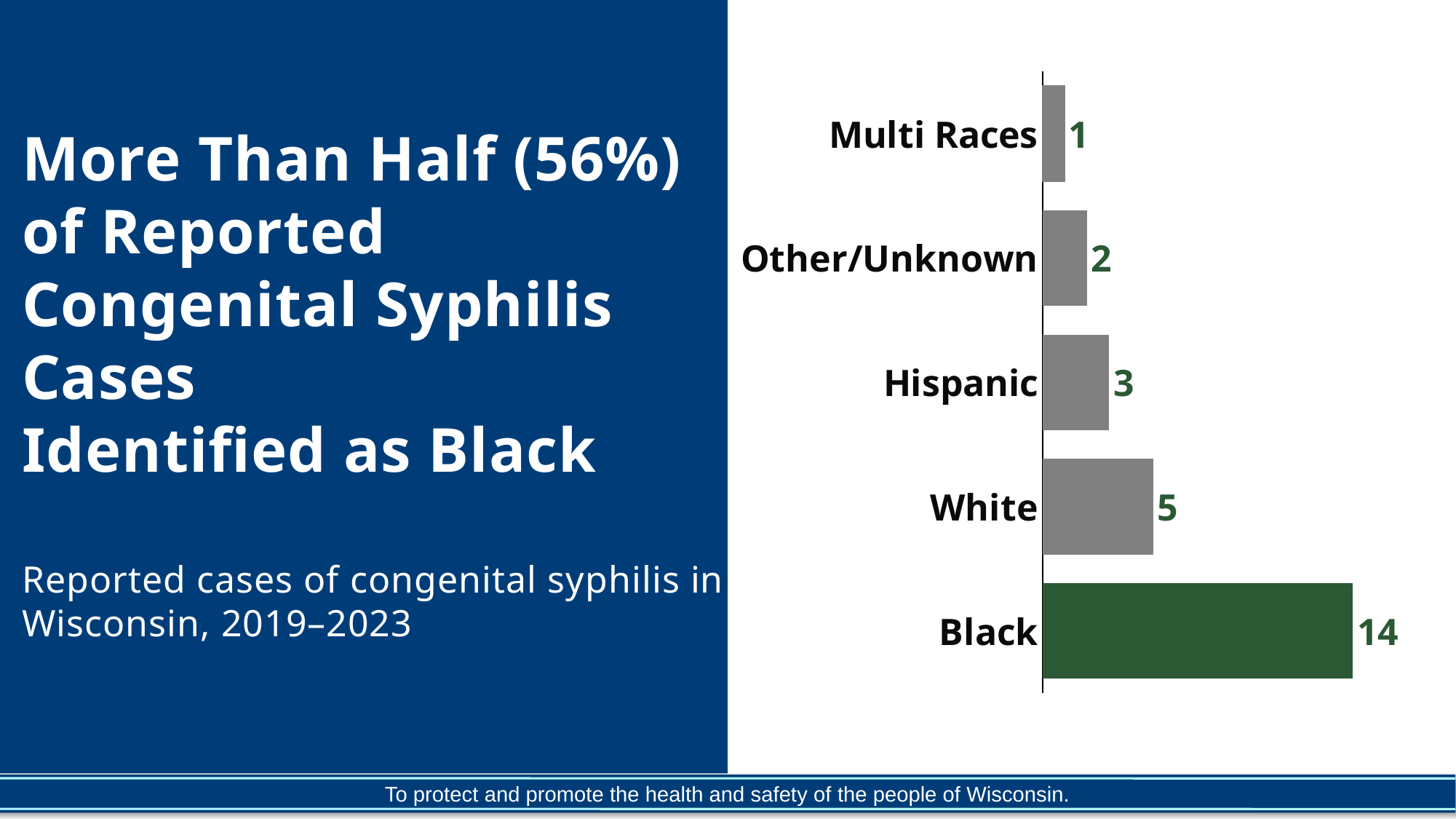
Which category has the highest number of cases? Black How many reported congenital syphilis cases are shown for Black? 14 What is the value shown for White? 5 What kind of chart is shown on the slide? Bar chart Which is larger, the value for Hispanic or the value for Other/Unknown? Hispanic What is the value shown for Multi Races? 1 Which bar is coloured green rather than grey? Black Which category has the lowest number of cases? Multi Races What is the value shown for Other/Unknown? 2 What is the value shown for Hispanic? 3 How many categories are shown in the chart? 5 What is the difference between the values for Black and White? 9